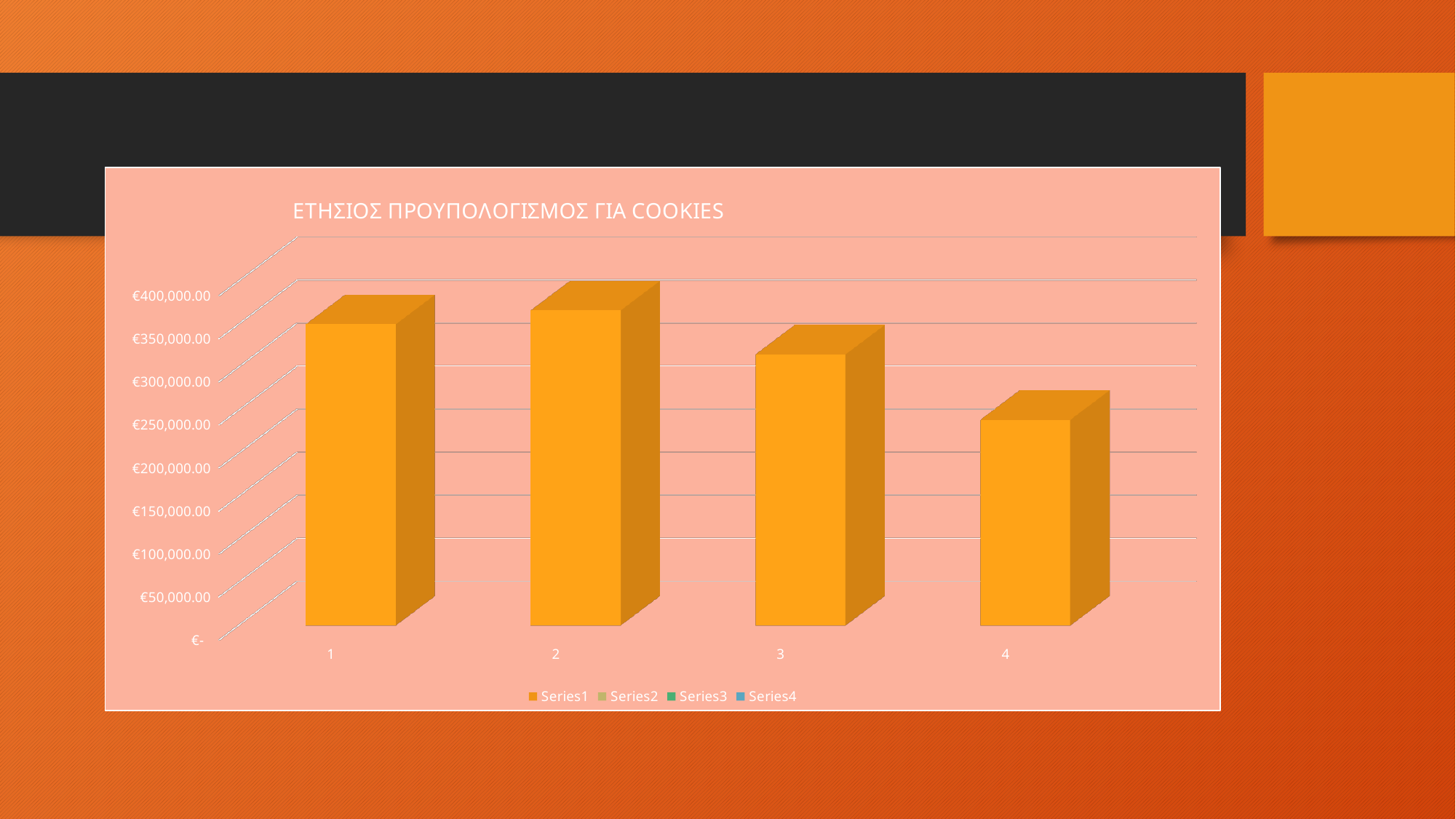
Which is larger, the value for category 1 or the value for category 3? 1 Is the value for category 2 greater or less than €300,000.00? greater Which category has the highest bar in the chart? 2 Do the values rise or fall from category 2 to category 4? fall How many categories are shown on the x axis of the chart? 4 Which is larger, the value for category 3 or the value for category 4? 3 How many series does the chart's legend list? 4 Is the value for category 4 greater or less than €300,000.00? less Is the value for category 3 greater or less than €250,000.00? greater What kind of chart is shown on the slide? bar chart Which category has the lowest bar in the chart? 4 What is the title of the chart? ΕΤΗΣΙΟΣ ΠΡΟΥΠΟΛΟΓΙΣΜΟΣ ΓΙΑ COOKIES